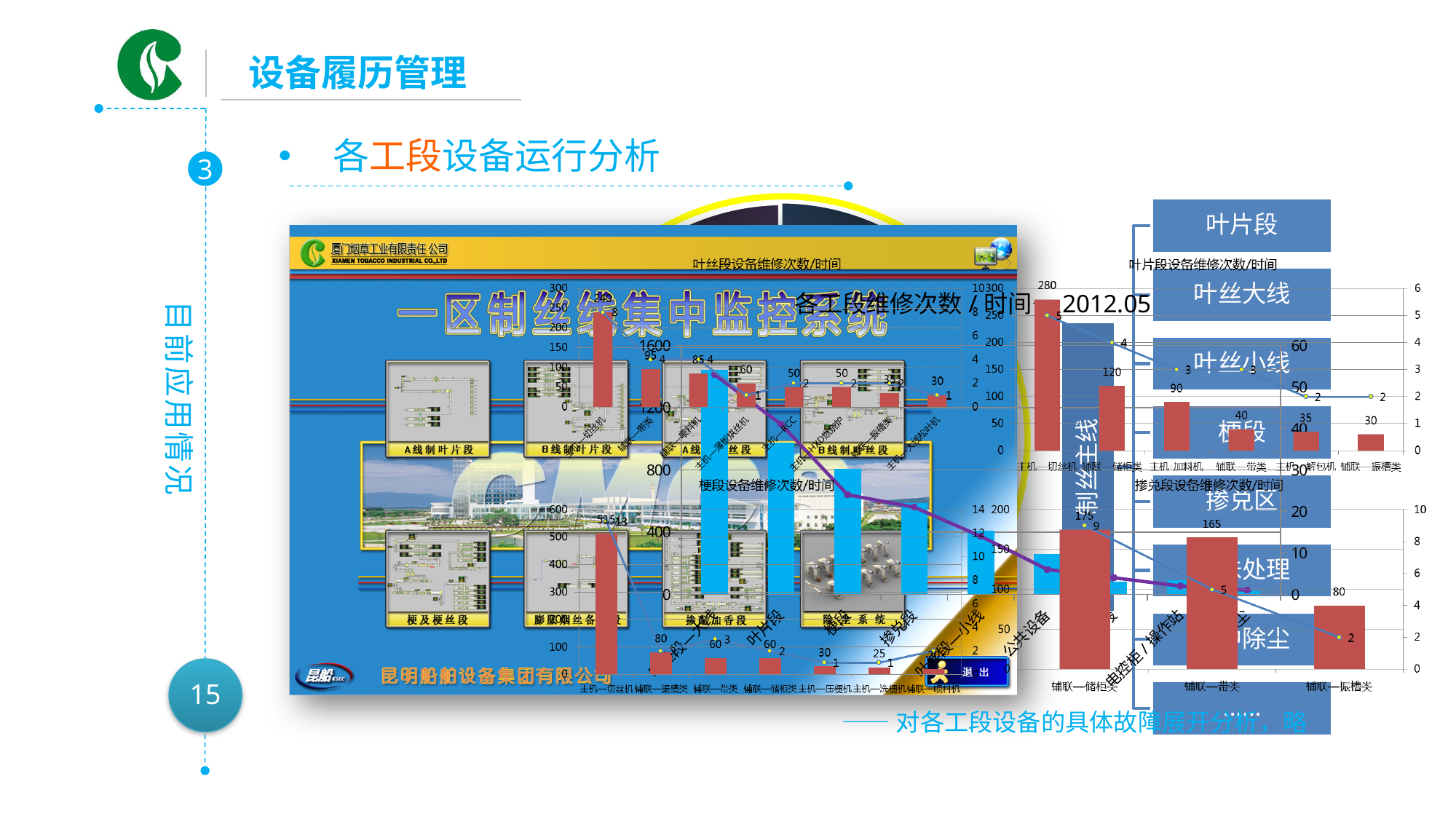
In the 掺兑段设备维修次数/时间 chart, what is the bar value for 辅联—振槽类? 80 In the 叶片段设备维修次数/时间 chart, what is the difference between the bar values for 主机—切丝机 and 辅联—储柜类? 160 In the 叶片段设备维修次数/时间 chart, what is the bar value for 主机—切丝机? 280 In the 叶片段设备维修次数/时间 chart, which bar is larger: 主机—加料机 or 辅联—振槽类? 主机—加料机 In the 掺兑段设备维修次数/时间 chart, what is the difference between the bar values for 辅联—储柜类 and 辅联—振槽类? 95 In the 掺兑段设备维修次数/时间 chart, which category has the lowest bar value? 辅联—振槽类 In the 叶片段设备维修次数/时间 chart, which category has the highest bar value? 主机—切丝机 What kind of chart is the 掺兑段设备维修次数/时间 chart? bar chart with a line In the 叶片段设备维修次数/时间 chart, what is the bar value for 辅联—储柜类? 120 In the 掺兑段设备维修次数/时间 chart, what is the bar value for 辅联—储柜类? 175 How many categories are shown in the 掺兑段设备维修次数/时间 chart? 3